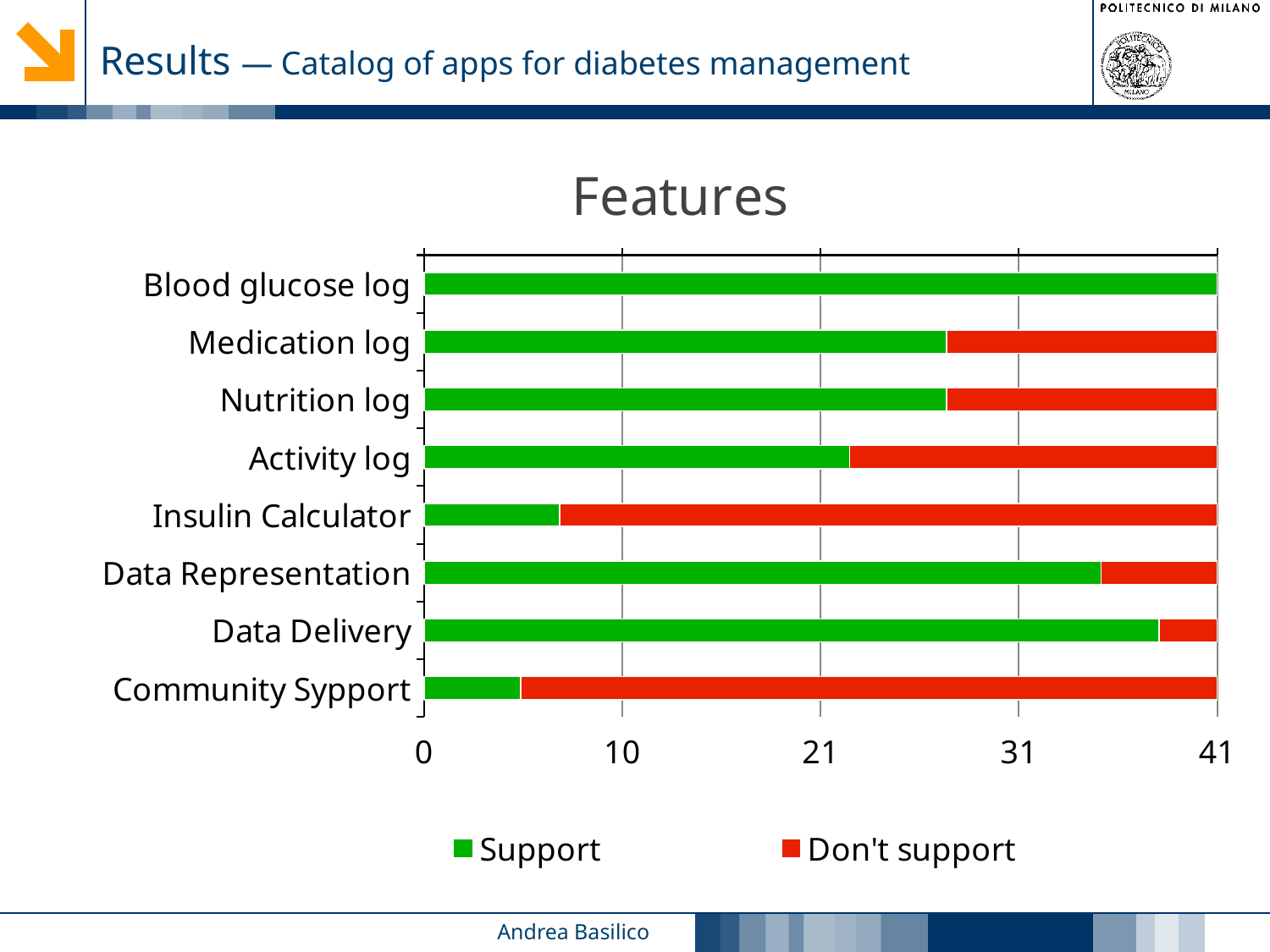
Which colour represents the Don't support series in the legend? red What is the title of the chart? Features What kind of chart is shown on the slide? bar chart What is the Support value for Blood glucose log? 41 Which has the larger Support value, Data Delivery or Data Representation? Data Delivery Is the Support value for Data Delivery greater or less than 31? greater How many series does the legend list? 2 Is the Support value for Medication log greater or less than 21? greater Which feature has the lowest Support value? Community Sypport Which feature has the highest Support value? Blood glucose log How many feature categories are plotted in the chart? 8 Is the Support value for Insulin Calculator greater or less than 10? less